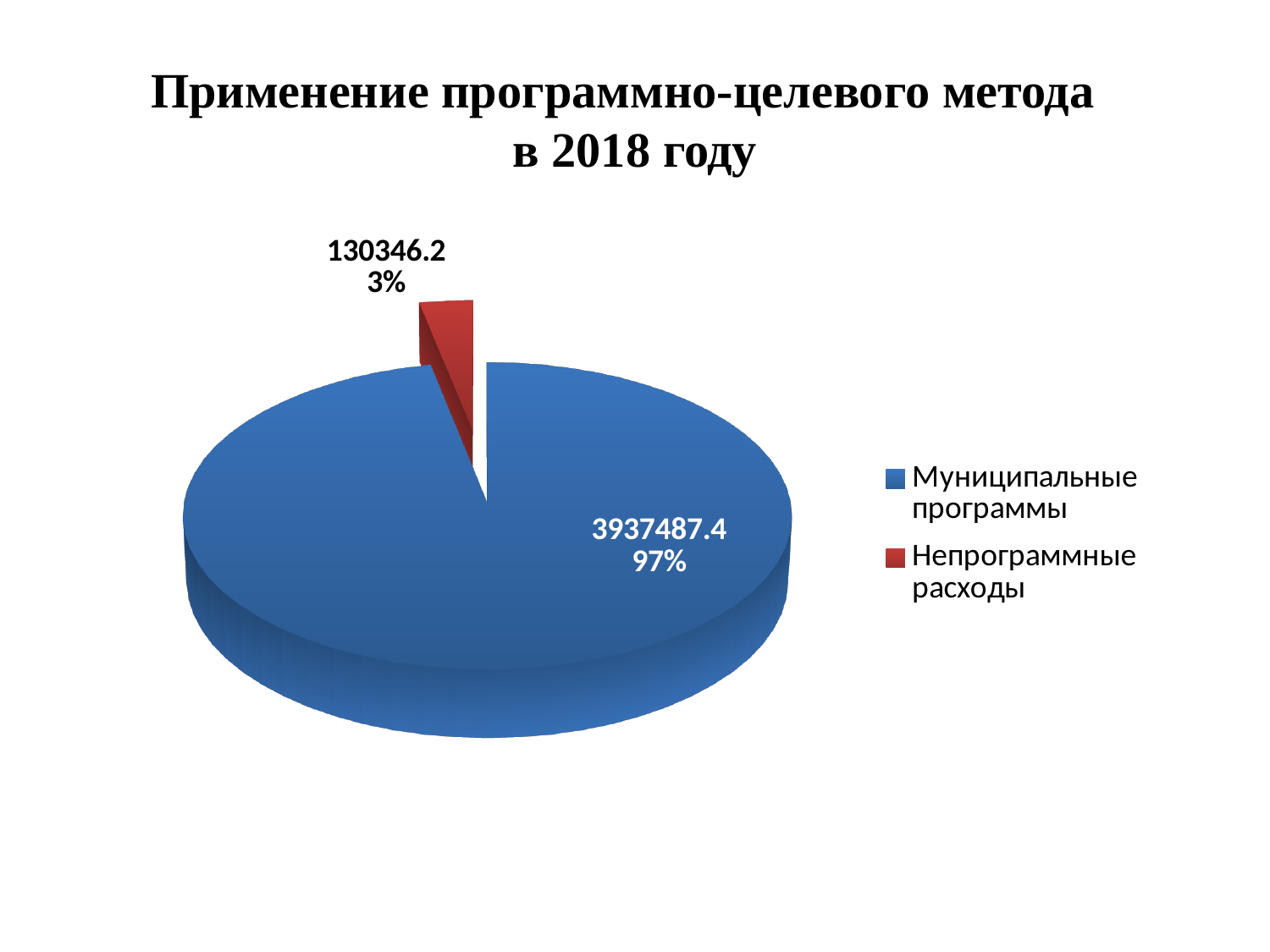
What kind of chart is shown on the slide? pie chart What colour is the slice for Непрограммные расходы? red How many categories does the pie chart show? 2 What is the value for Муниципальные программы? 3937487.4 Which is larger, Муниципальные программы or Непрограммные расходы? Муниципальные программы What share of the pie does Непрограммные расходы take? 3% Which category has the smallest slice? Непрограммные расходы Which category has the largest slice? Муниципальные программы What is the value for Непрограммные расходы? 130346.2 What share of the pie does Муниципальные программы take? 97% What is the difference between the values for Муниципальные программы and Непрограммные расходы? 3807141.2 What is the title of the slide? Применение программно-целевого метода в 2018 году